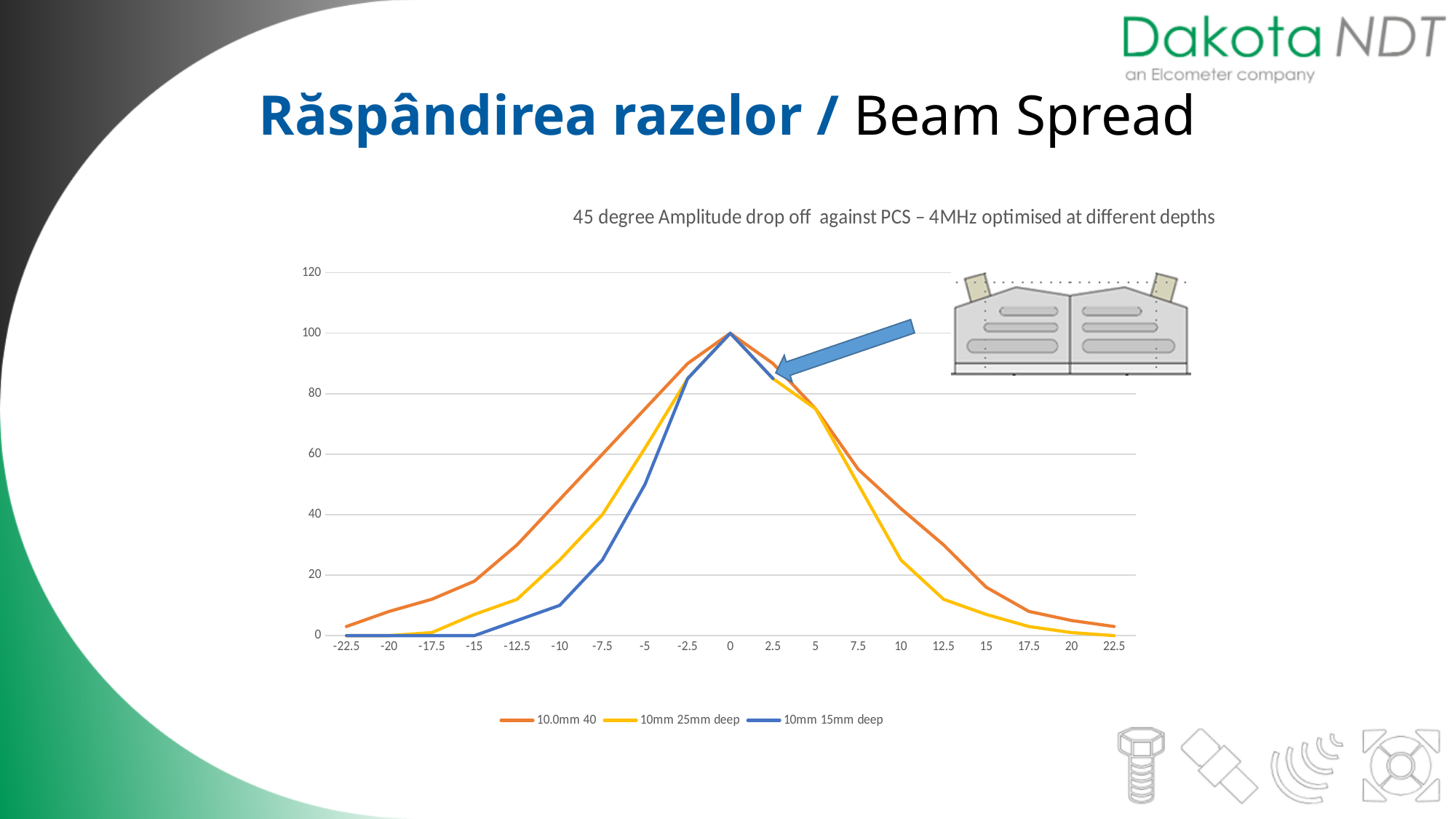
What kind of chart is shown on the slide? line chart How many points are there along the x axis? 19 What is the value of the 10mm 25mm deep series at 22.5? 0 Is the value of the 10mm 15mm deep series at -10 greater or less than 20? less What is the value of the 10mm 15mm deep series at -15? 0 Which series is drawn in orange? 10.0mm 40 At which x value do all three series reach their highest point? 0 How many series does the legend list? 3 What is the chart's title? 45 degree Amplitude drop off against PCS – 4MHz optimised at different depths What is the value of the 10mm 15mm deep series at 0? 100 At -7.5, which series has the larger value: 10.0mm 40 or 10mm 15mm deep? 10.0mm 40 Is the value of the 10.0mm 40 series at -12.5 greater or less than 20? greater